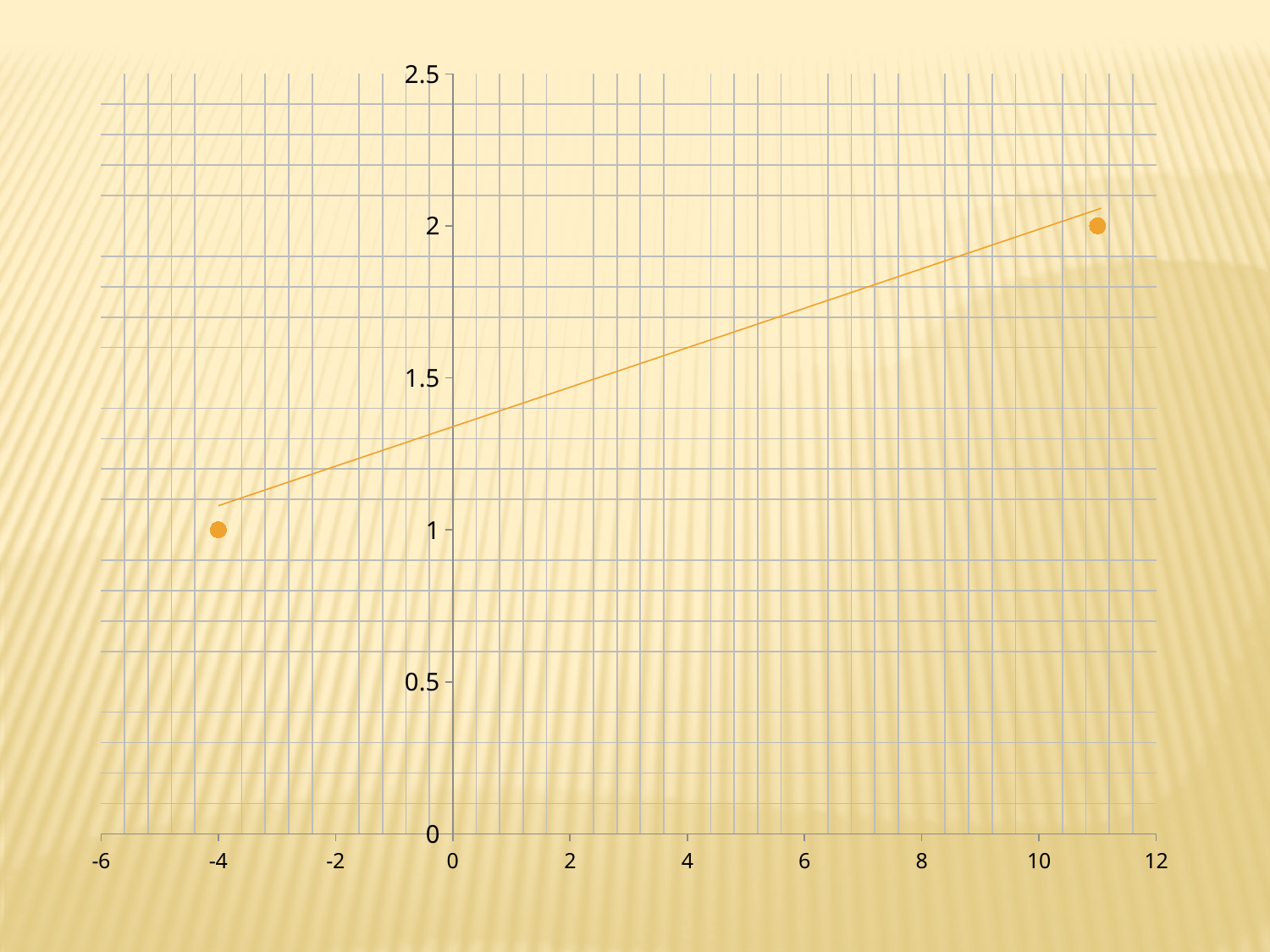
Is the y value of the rightmost data point greater or less than 1.5? greater Is the x value of the rightmost data point greater or less than 10? greater What kind of chart is shown on the slide? scatter chart Which data point has the higher y value, the one at x = -4 or the rightmost one? the rightmost one What is the x value of the leftmost data point? -4 What is the difference in y value between the rightmost data point and the data point at x = -4? 1 How many data points are plotted on the chart? 2 Does the chart include a trendline through the data points? Yes What is the y value of the data point at x = -4? 1 Is the y value of the leftmost data point greater or less than 1.5? less Do the y values rise or fall as x increases along the chart? rise What is the y value of the rightmost data point? 2